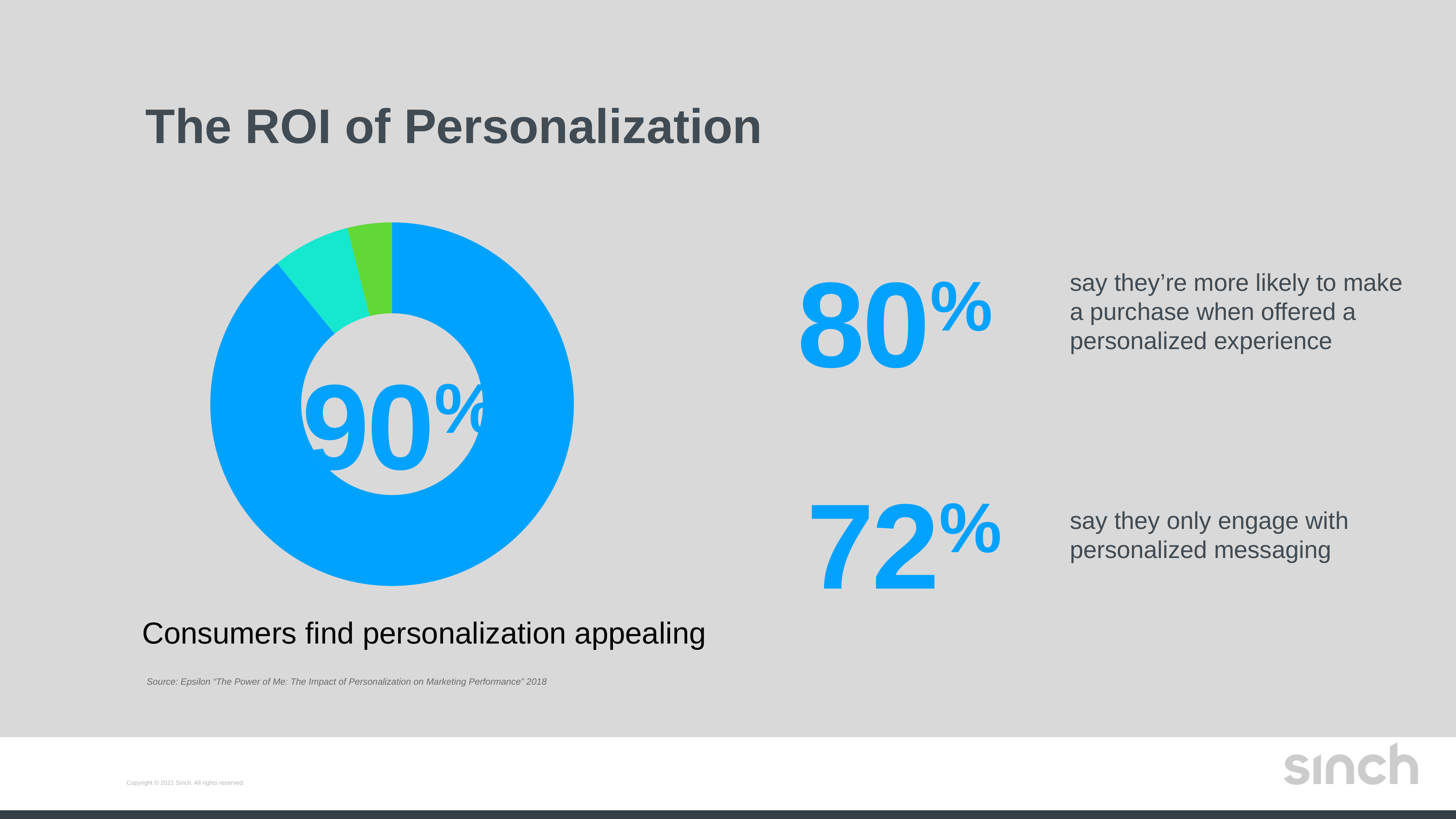
Which colour slice is the largest in the donut chart? Blue What caption appears below the donut chart? Consumers find personalization appealing What is the title of the slide containing the donut chart? The ROI of Personalization How many slices does the donut chart have? 3 What percentage is printed in the centre of the donut chart? 90% Is the blue slice larger or smaller than the teal slice? Larger Which colour slice is the smallest in the donut chart? Green What kind of chart is shown on the slide? Donut (pie) chart Does the blue slice of the donut chart cover more or less than half of the ring? More